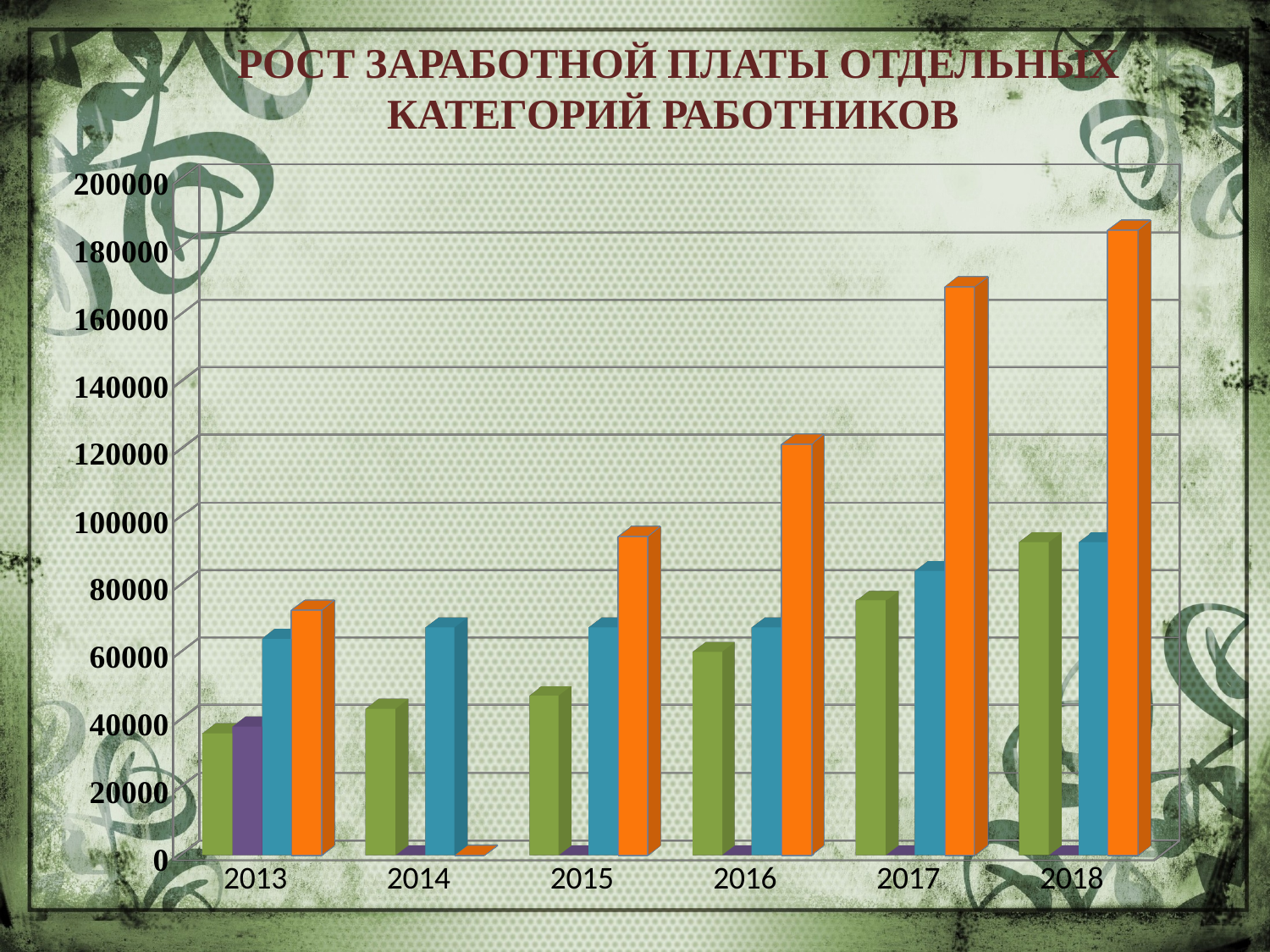
Is the value of the green bar for 2013 greater or less than 40000? less How many years are shown on the x axis of the chart? 6 In which year is the green bar the lowest? 2013 In which year is the orange bar the highest? 2018 What is the title of the chart? РОСТ ЗАРАБОТНОЙ ПЛАТЫ ОТДЕЛЬНЫХ КАТЕГОРИЙ РАБОТНИКОВ Which is larger in 2017, the orange bar or the blue bar? the orange bar Is the value of the green bar for 2017 greater or less than 80000? less Do the green bars rise or fall from 2013 to 2018? rise Is the value of the orange bar for 2017 greater or less than 160000? greater Which is larger, the green bar for 2018 or the green bar for 2013? the green bar for 2018 What kind of chart is shown on the slide? bar chart